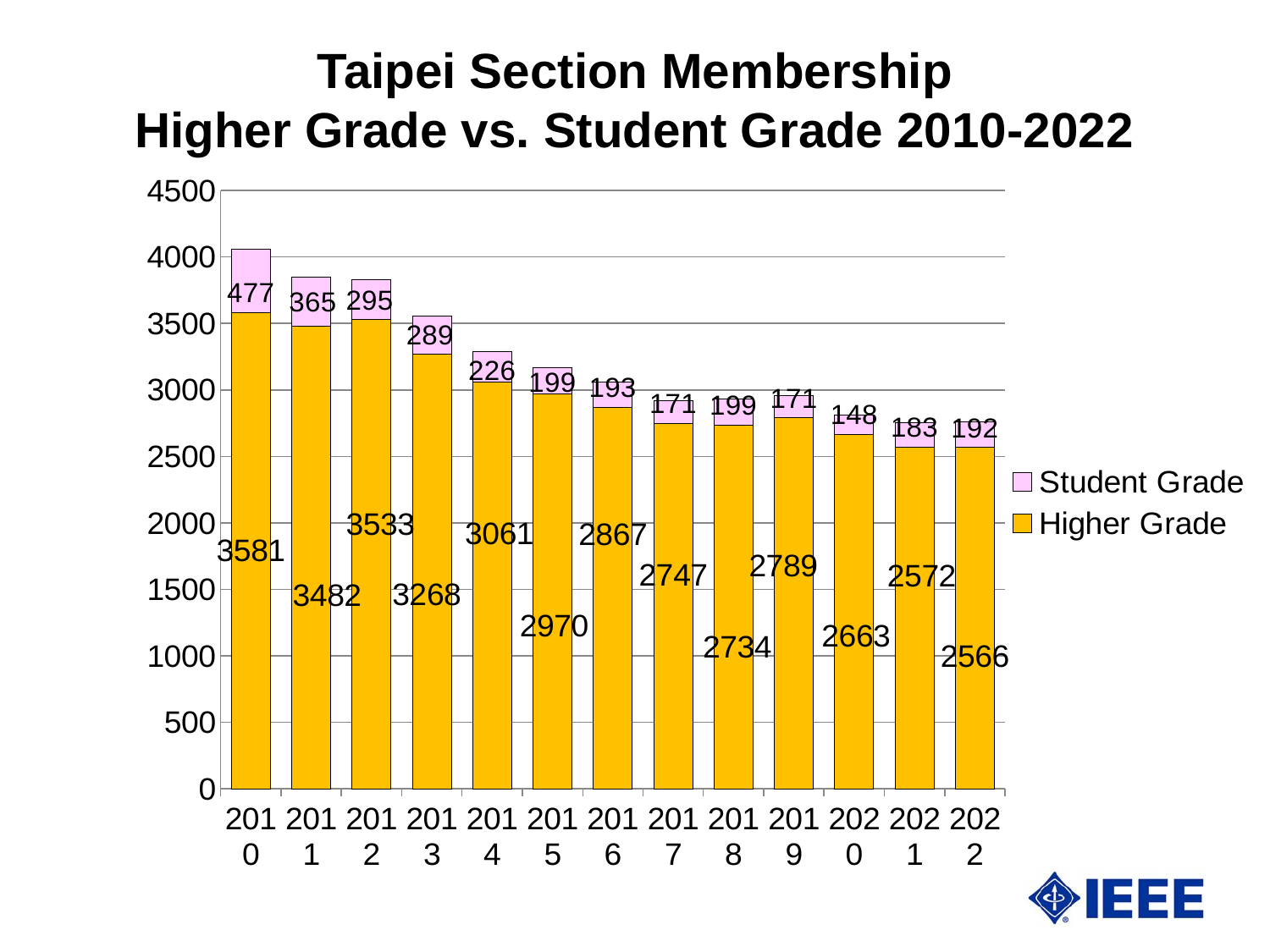
What is the Higher Grade membership value for 2019? 2789 Which is larger, the Student Grade value for 2021 or for 2022? 2022 Which year has the highest Student Grade membership? 2010 What is the total membership (Higher Grade plus Student Grade) for 2022? 2758 What is the Student Grade membership value for 2020? 148 What kind of chart is shown on the slide? Stacked bar chart What is the Higher Grade membership value for 2010? 3581 What is the total membership (Higher Grade plus Student Grade) for 2010? 4058 What is the difference between the Higher Grade values for 2010 and 2011? 99 Which year has the lowest Higher Grade membership? 2022 How many years are shown on the x axis? 13 How many series does the legend list? 2